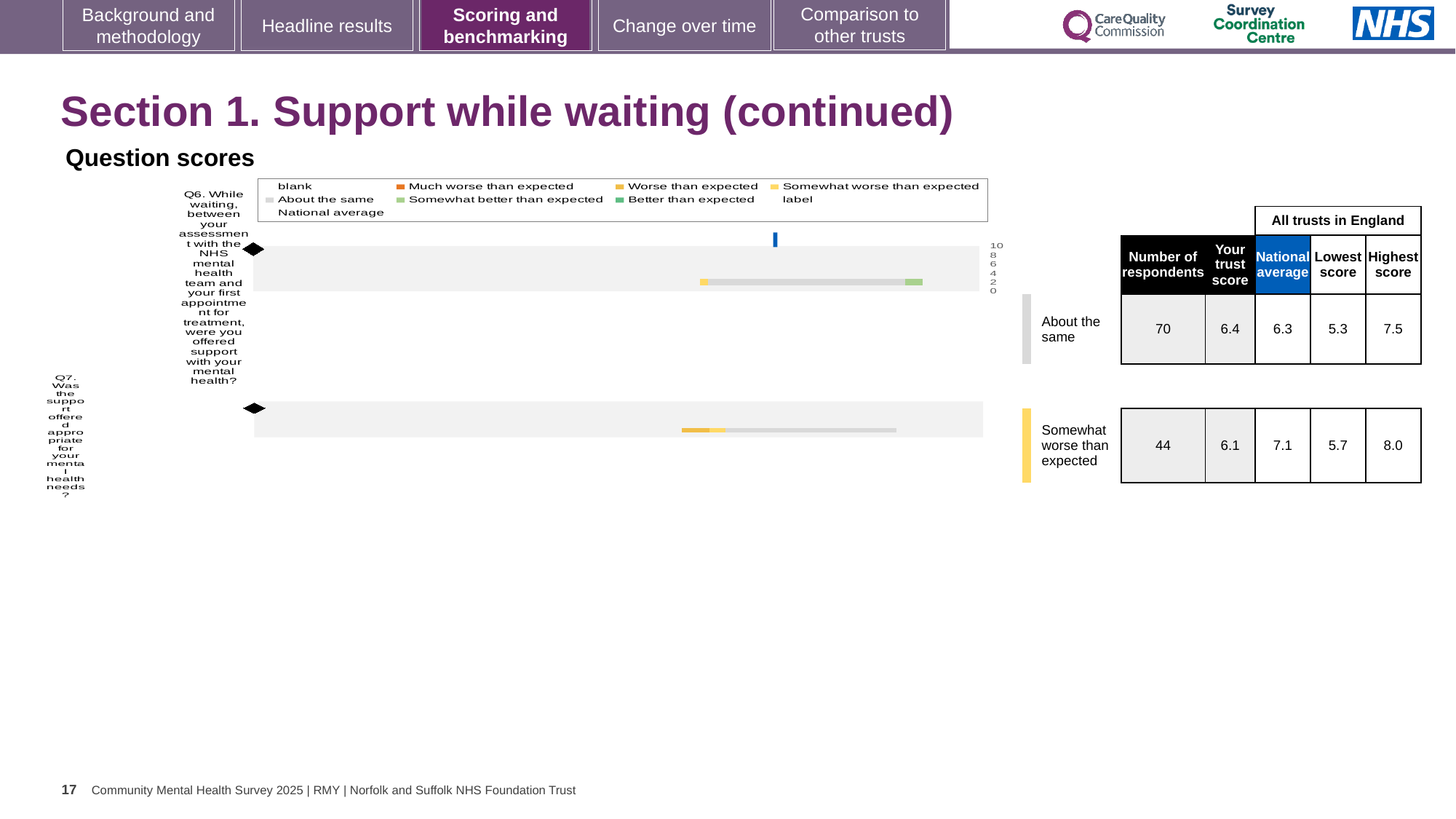
In the table beside the chart, how many respondents are recorded for Q7? 44 How many questions (categories) are plotted in the Question scores chart? 2 In the table beside the chart, what is the lowest score across all trusts in England for Q7? 5.7 How many entries does the legend of the Question scores chart list? 9 What is the first entry listed in the chart legend? blank What colour is the 'Better than expected' entry in the chart legend? green Which question has the higher 'Your trust score' in the table beside the chart, Q6 or Q7? Q6 What benchmark category label is shown next to the Q7 bar? Somewhat worse than expected In the table beside the chart, what is the highest score across all trusts in England for Q6? 7.5 In the table beside the chart, what is the 'Your trust score' for Q6? 6.4 In the table beside the chart, what is the difference between the national average and the trust score for Q7? 1.0 What kind of chart is shown under 'Question scores'? bar chart